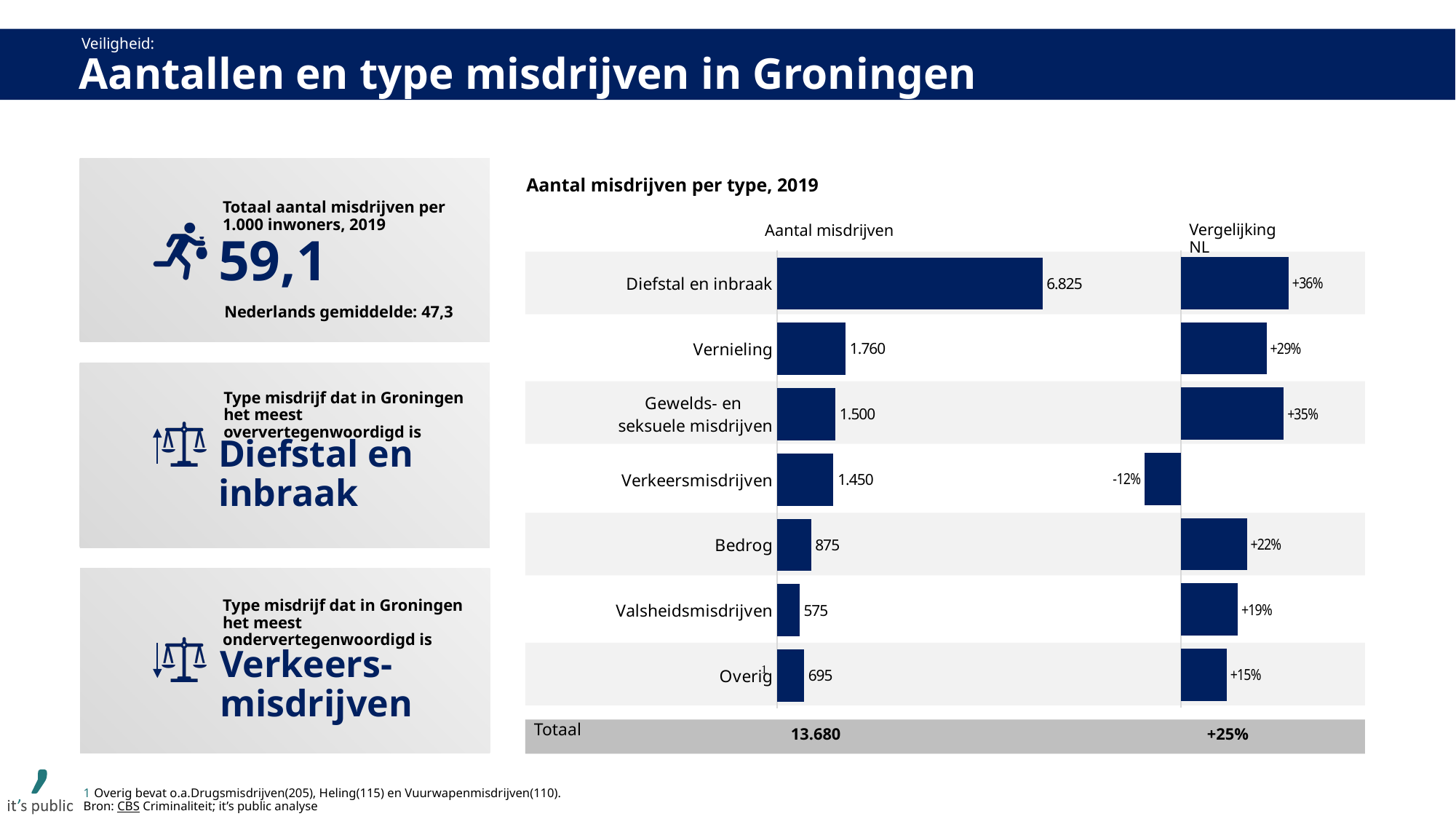
In the chart 'Aantal misdrijven per type, 2019', what is the Totaal value for Aantal misdrijven? 13.680 In the chart 'Aantal misdrijven per type, 2019', which crime type has the highest Aantal misdrijven? Diefstal en inbraak In the chart 'Aantal misdrijven per type, 2019', what is the Vergelijking NL value for Verkeersmisdrijven? -12% In the chart 'Aantal misdrijven per type, 2019', what is the Aantal misdrijven value for Bedrog? 875 In the chart 'Aantal misdrijven per type, 2019', which crime type has the lowest Aantal misdrijven? Valsheidsmisdrijven In the chart 'Aantal misdrijven per type, 2019', how many crime types are shown (excluding the Totaal row)? 7 In the chart 'Aantal misdrijven per type, 2019', which crime type has the lowest Vergelijking NL value? Verkeersmisdrijven In the chart 'Aantal misdrijven per type, 2019', which has a higher Aantal misdrijven: Bedrog or Overig? Bedrog In the chart 'Aantal misdrijven per type, 2019', what is the Aantal misdrijven value for Diefstal en inbraak? 6.825 What kind of chart is 'Aantal misdrijven per type, 2019'? Bar chart In the chart 'Aantal misdrijven per type, 2019', what is the difference in Aantal misdrijven between Diefstal en inbraak and Vernieling? 5.065 In the chart 'Aantal misdrijven per type, 2019', what is the Vergelijking NL value for Gewelds- en seksuele misdrijven? +35%